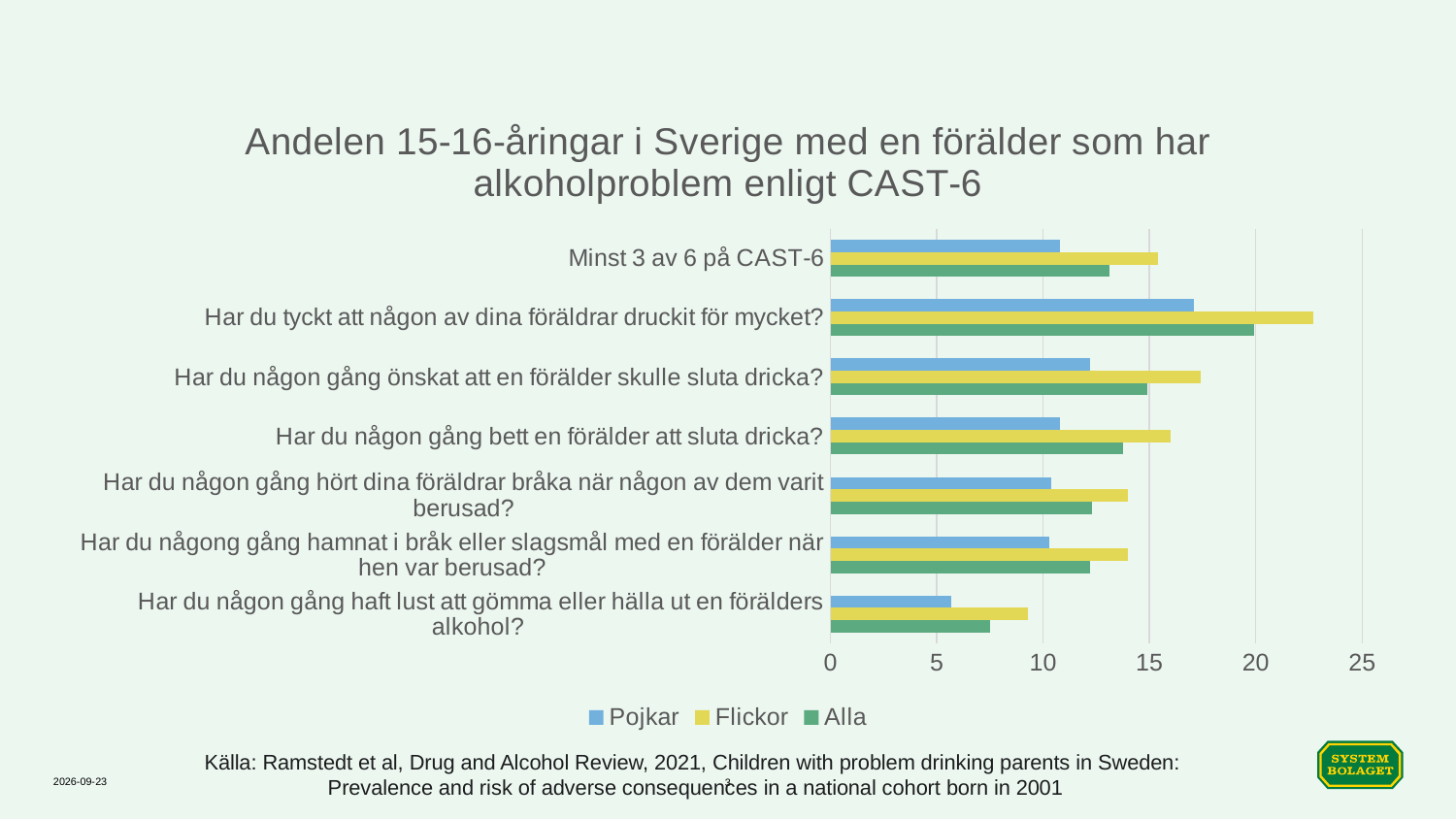
For "Minst 3 av 6 på CAST-6", which series has the larger value, Pojkar or Flickor? Flickor How many series does the legend list? 3 What kind of chart is shown on the slide? Bar chart Is the Flickor value for "Har du någon gång önskat att en förälder skulle sluta dricka?" greater or less than 15? greater Which is larger: the Alla value for "Har du tyckt att någon av dina föräldrar druckit för mycket?" or the Alla value for "Minst 3 av 6 på CAST-6"? Har du tyckt att någon av dina föräldrar druckit för mycket? How many categories (questions) are plotted on the y axis? 7 Is the Pojkar value for "Har du någon gång haft lust att gömma eller hälla ut en förälders alkohol?" greater or less than 10? less Which category has the highest value for Flickor? Har du tyckt att någon av dina föräldrar druckit för mycket? What are the three series listed in the legend? Pojkar, Flickor, Alla Is the Flickor value for "Har du tyckt att någon av dina föräldrar druckit för mycket?" greater or less than 20? greater Which category has the lowest value for Alla? Har du någon gång haft lust att gömma eller hälla ut en förälders alkohol?